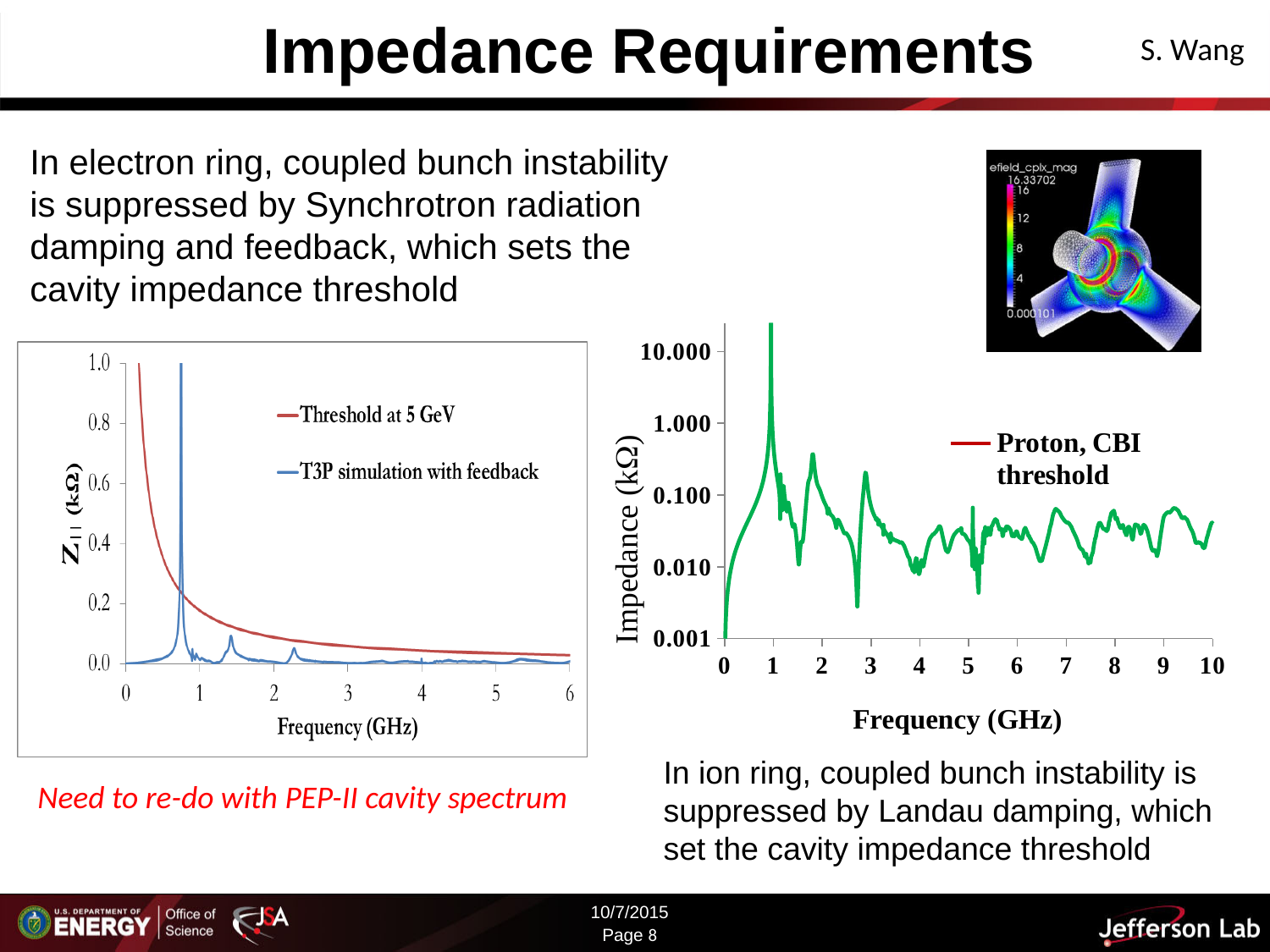
On the right chart, is the impedance at 4 GHz greater or less than 0.100 kΩ? less What kind of chart is the left chart (Z|| versus Frequency)? line chart What is the highest tick value shown on the y-axis of the right chart? 10.000 On the right chart, is the impedance at 1 GHz greater or less than 1.000 kΩ? greater How many entries does the legend of the right chart list? 1 On the left chart, is the 'Threshold at 5 GeV' value at 4 GHz greater or less than 0.2? less On the left chart, does the 'Threshold at 5 GeV' curve rise or fall as frequency increases? fall What are the two legend entries on the left chart? Threshold at 5 GeV; T3P simulation with feedback What kind of chart is the right chart (Impedance versus Frequency)? line chart How many series does the legend of the left chart list? 2 What is the x-axis label of the left chart? Frequency (GHz)